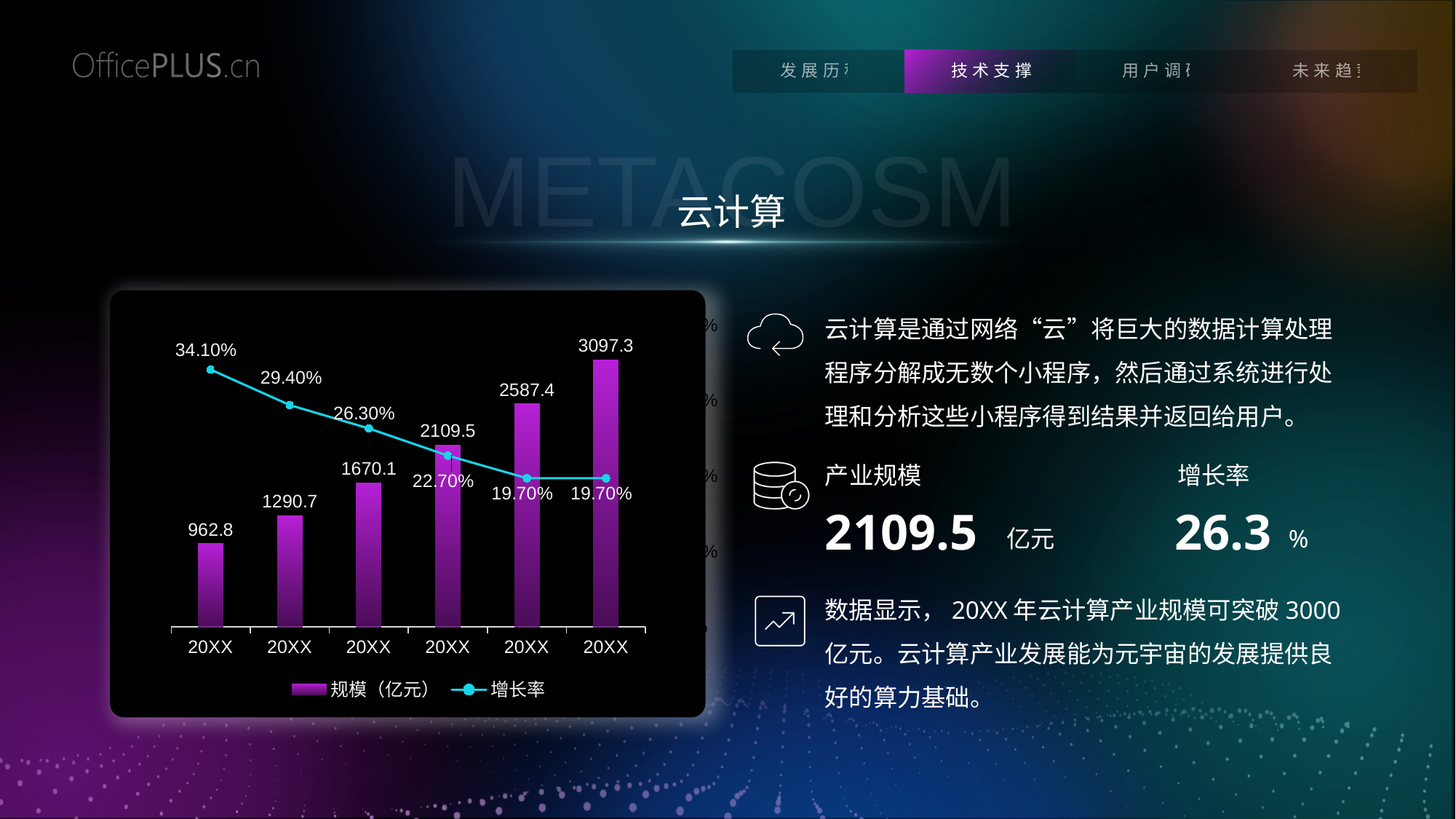
What is the lowest value shown for the 规模（亿元） bars? 962.8 How many series does the legend list? 2 What is the difference between the first and second 增长率 values on the line? 4.70% What is the difference between the largest and smallest 规模（亿元） bar values? 2134.5 What is the 规模（亿元） value for the fourth bar from the left? 2109.5 Which is larger: the 规模（亿元） value of the third bar (1670.1) or the fifth bar (2587.4)? 2587.4 What is the highest value shown for the 规模（亿元） bars? 3097.3 How many bars (categories) are plotted in the chart? 6 Do the 增长率 line values generally rise or fall from left to right? Fall What is the 增长率 value at the last point on the right of the line? 19.70% What is the 增长率 value at the first point on the left of the line? 34.10% What kind of chart is shown on the slide? Combined bar and line chart